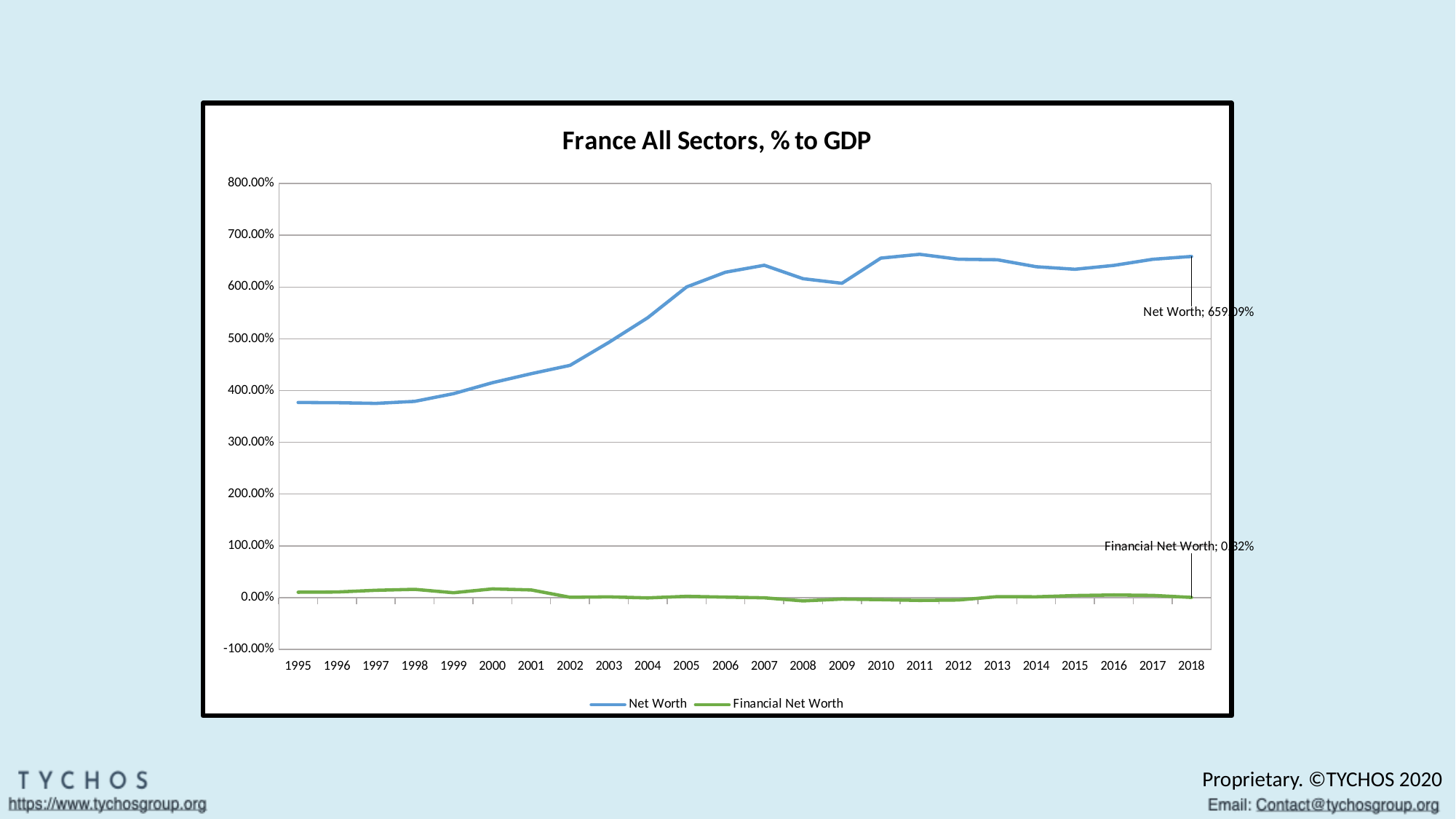
Which series has the higher value in 2018, Net Worth or Financial Net Worth? Net Worth Is the Net Worth value for 2010 greater or less than 600%? greater How many series does the legend list? 2 Is the Net Worth value for 2007 greater or less than 600%? greater Which is larger, the Net Worth value in 1995 or in 2018? 2018 How many years are shown on the x axis? 24 Does the Net Worth series generally rise or fall from 1995 to 2018? Rise What is the Net Worth value labelled for 2018? 659.09% What type of chart is shown on the slide? Line chart Is the Net Worth value for 1995 greater or less than 400%? less What is the title of the chart? France All Sectors, % to GDP